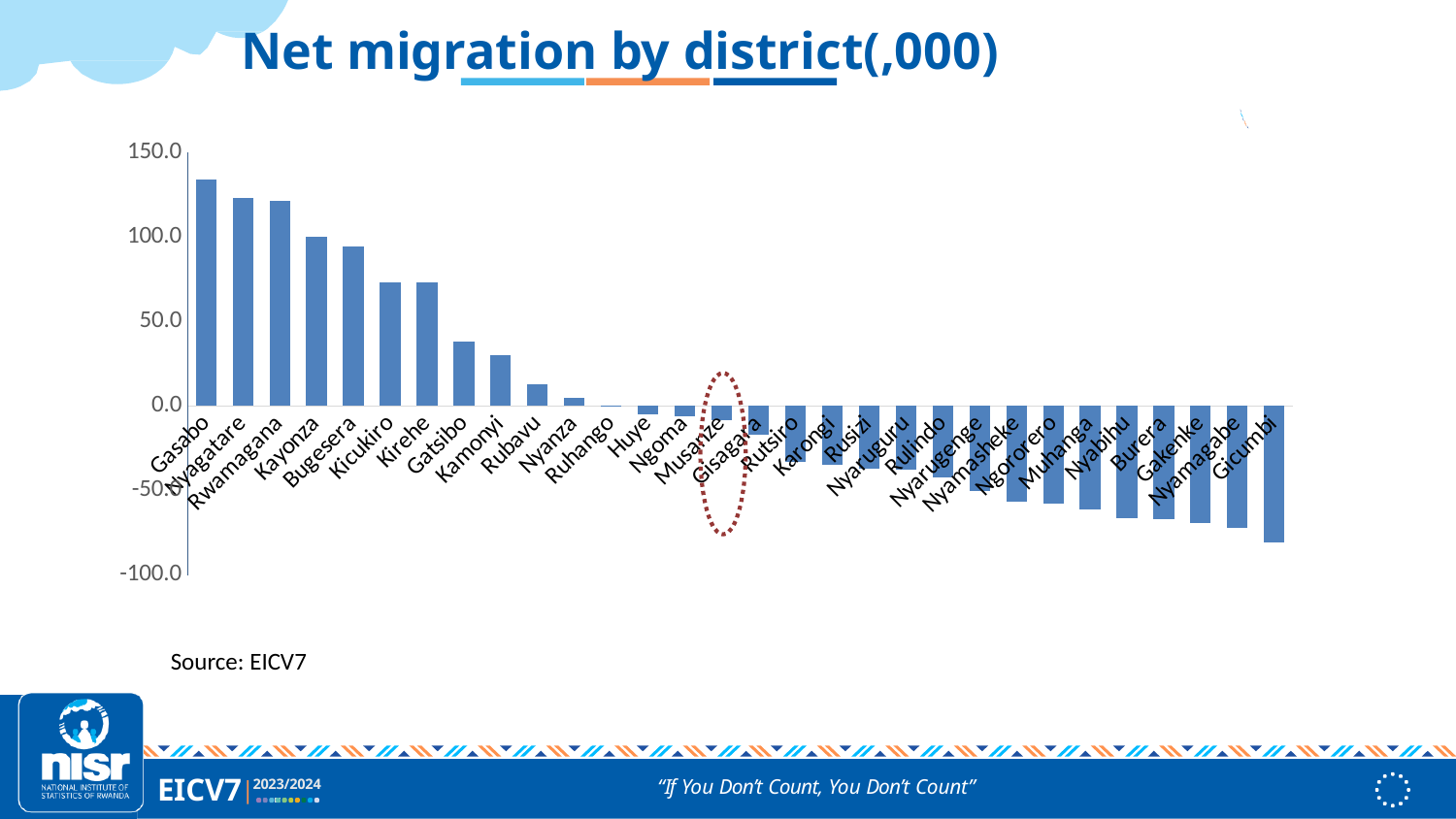
What is the title of the chart? Net migration by district(,000) Which district has a larger net migration, Gatsibo or Kamonyi? Gatsibo What type of chart is shown on the slide? Bar chart Is the value for Gasabo greater or less than 100.0? greater Is the value for Gatsibo greater or less than 50.0? less Which district has a larger net migration, Gasabo or Nyagatare? Gasabo Do the values rise or fall moving from left to right along the x axis? Fall Which district has the highest net migration? Gasabo How many districts are plotted in the chart? 30 Is the value for Gicumbi greater or less than -50.0? less Which district has the lowest net migration? Gicumbi